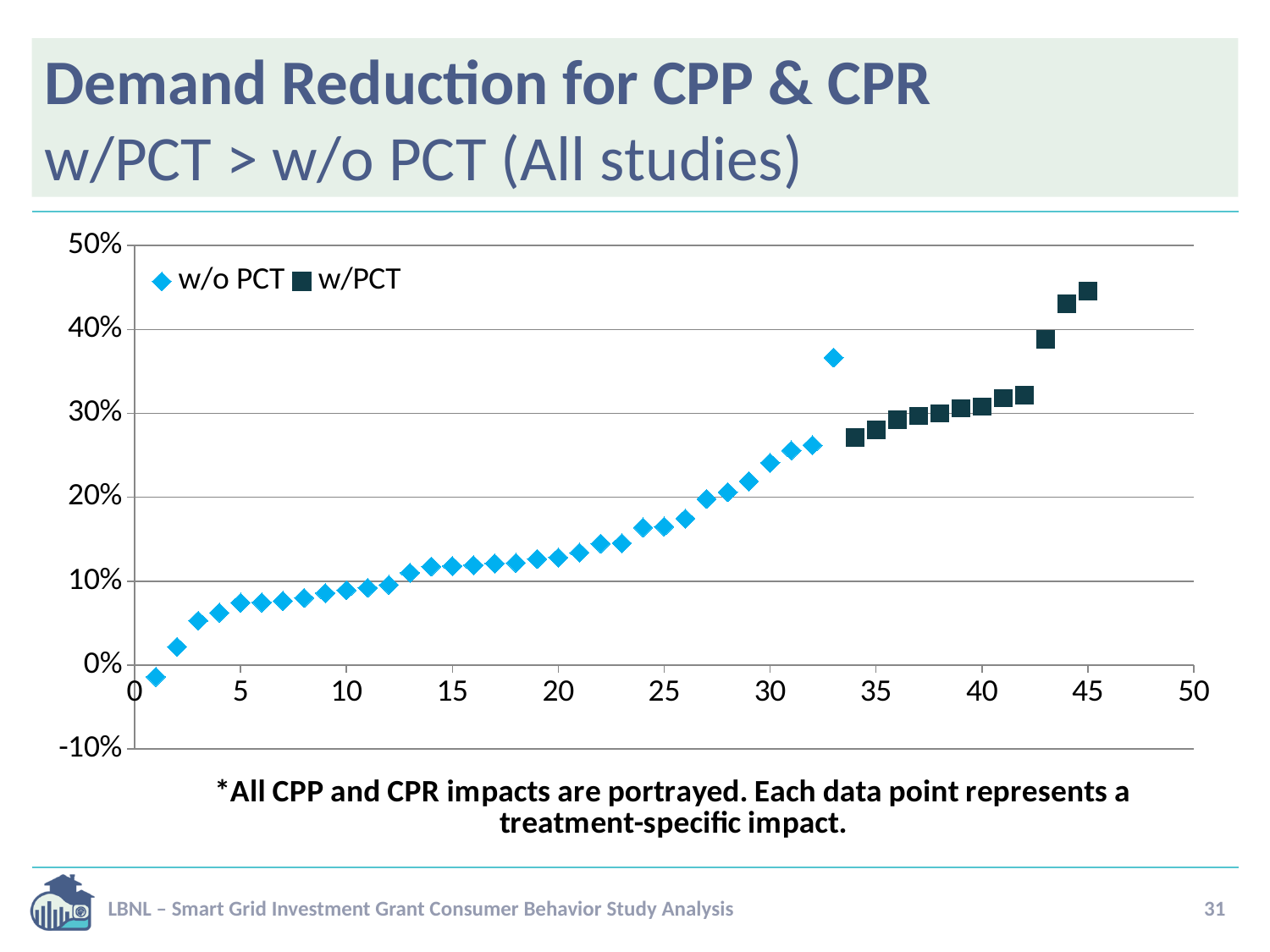
Which series contains the highest plotted value on the chart? w/PCT Do the plotted values rise or fall as you move from left to right along the x axis? Rise What kind of chart is shown on the slide? Scatter chart Which is larger: the w/o PCT point at x = 33 or the w/PCT point at x = 34? The w/o PCT point at x = 33 Which series is plotted with dark square markers? w/PCT Is the value of the w/o PCT point at x = 33 greater or less than 30%? greater Is the value of the w/PCT point at x = 45 greater or less than 40%? greater Which series contains the lowest plotted value on the chart? w/o PCT Is the value of the w/PCT point at x = 34 greater or less than 30%? less What are the two series named in the legend? w/o PCT and w/PCT How many series does the legend list? 2